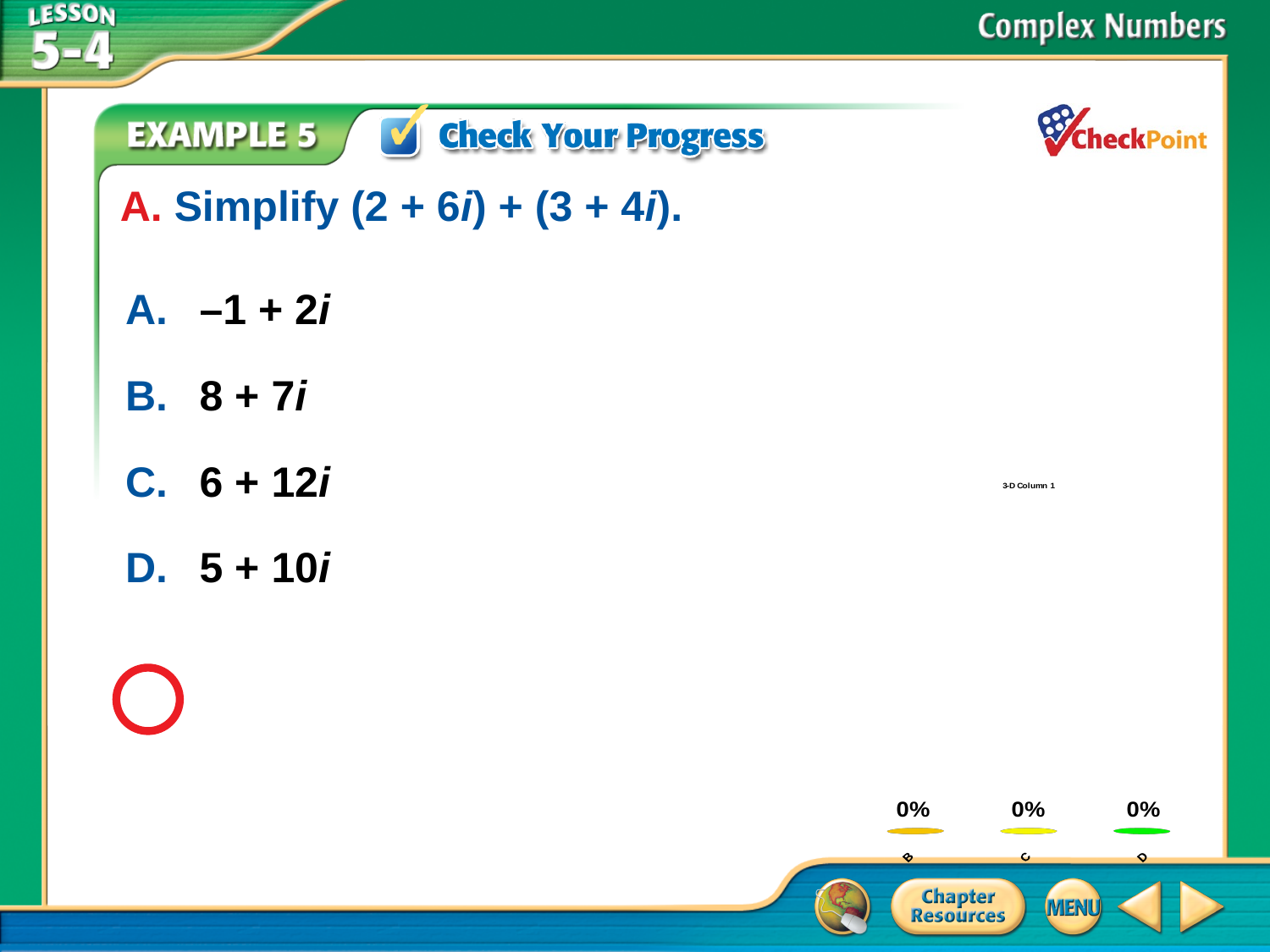
What value is shown for category B in the chart at the bottom right of the slide? 0% What value is shown for category C in the chart at the bottom right of the slide? 0% Do the values for B, C and D in the bottom-right chart differ from one another? No, all are 0% What value is shown for category D in the chart at the bottom right of the slide? 0% What kind of chart is shown at the bottom right of the slide? bar chart